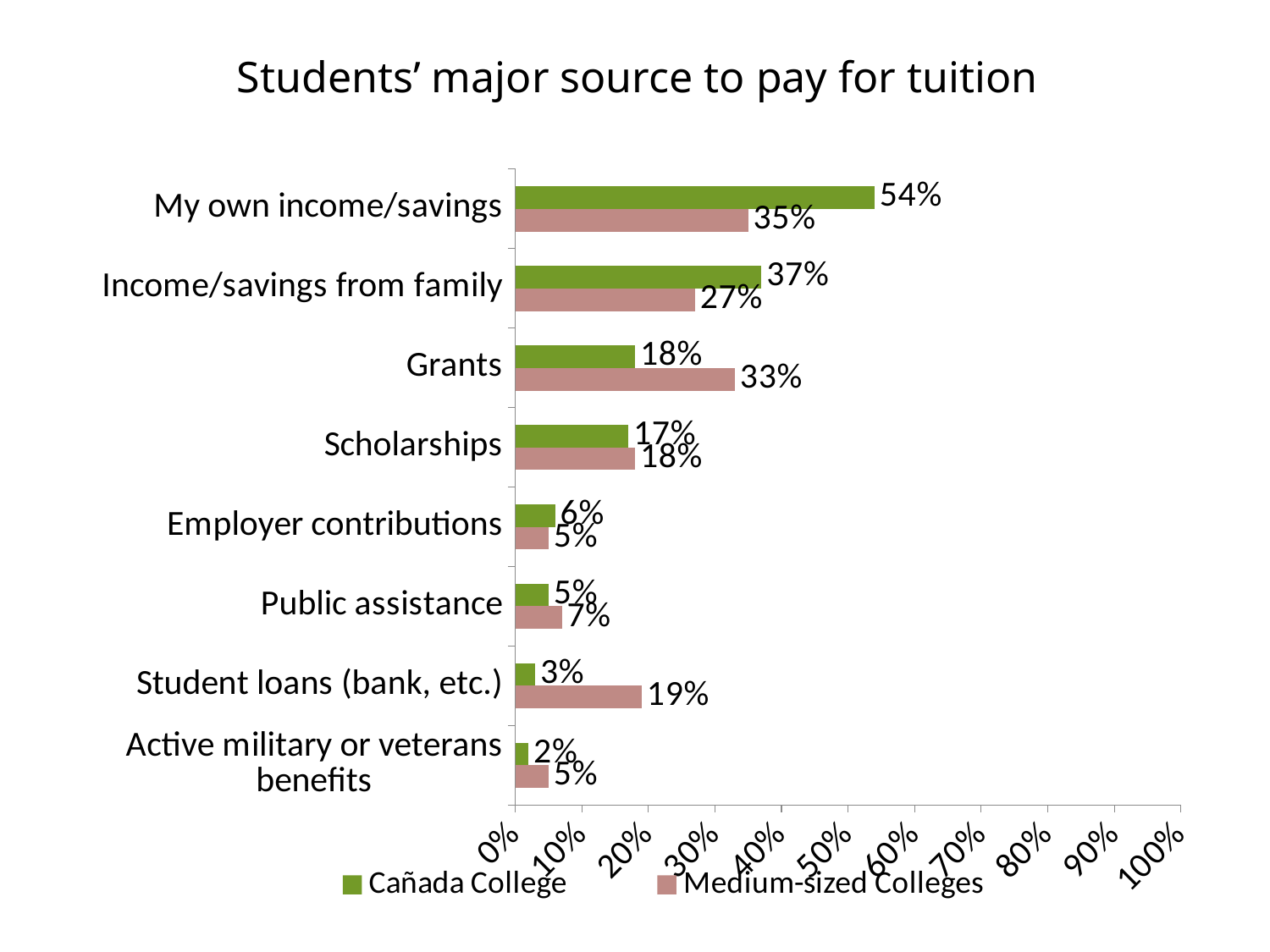
Which category has the highest value for Cañada College? My own income/savings What is the value for Cañada College for My own income/savings? 54% Which is larger for Grants: Cañada College or Medium-sized Colleges? Medium-sized Colleges How many categories are shown on the chart? 8 What is the difference between Cañada College and Medium-sized Colleges for My own income/savings? 19% What kind of chart is shown on the slide? Bar chart Which category has the lowest value for Cañada College? Active military or veterans benefits What is the title of the chart? Students' major source to pay for tuition How many series does the legend list? 2 What is the value for Medium-sized Colleges for Grants? 33% What is the value for Medium-sized Colleges for Student loans (bank, etc.)? 19% Is the value for Medium-sized Colleges for Income/savings from family greater or less than 20%? greater